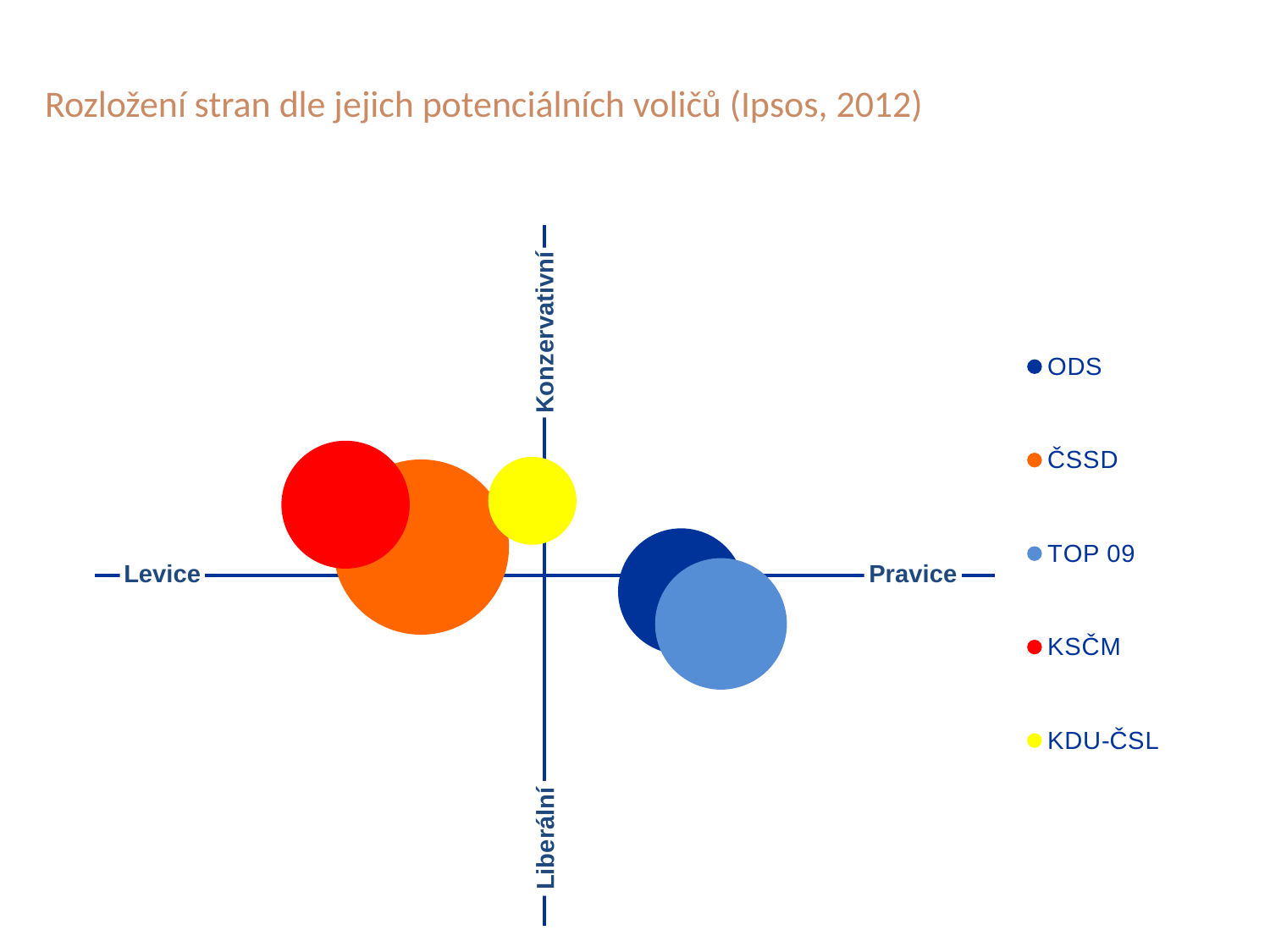
How many parties does the legend list? 5 Which party has the largest bubble? ČSSD Which is positioned higher on the vertical axis (more Konzervativní), KDU-ČSL or TOP 09? KDU-ČSL Which is positioned further to the right on the horizontal axis, ODS or KSČM? ODS What colour is the bubble for KSČM? red Which party is positioned lowest, i.e. most toward Liberální, on the vertical axis? TOP 09 How many bubbles are plotted on the chart? 5 What kind of chart is shown on the slide? bubble chart What is the title of the chart? Rozložení stran dle jejich potenciálních voličů (Ipsos, 2012) Which party is positioned furthest to the left (Levice) on the horizontal axis? KSČM Which party has the smallest bubble? KDU-ČSL Which party is positioned furthest to the right (Pravice) on the horizontal axis? TOP 09